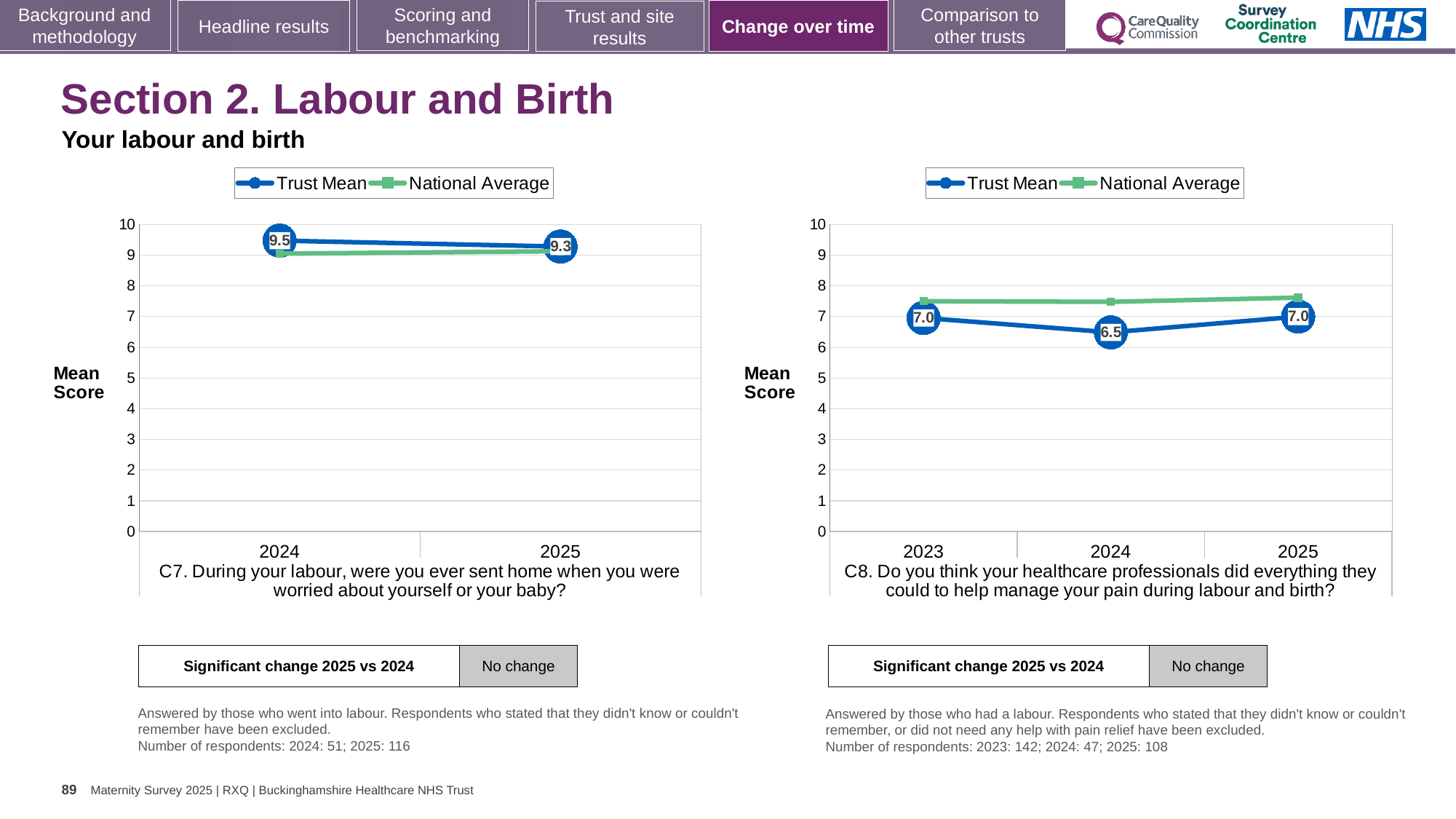
How many years are plotted on the x axis of the right chart (C8)? 3 In the right chart (C8), what is the difference between the Trust Mean for 2025 and 2024? 0.5 In the right chart (C8), which year has the lowest Trust Mean? 2024 In the left chart (C7), what is the Trust Mean for 2025? 9.3 In the right chart (C8), is the National Average for 2024 higher or lower than the Trust Mean for 2024? higher In the left chart (C7), what is the difference between the Trust Mean for 2024 and 2025? 0.2 In the right chart (C8), what is the Trust Mean for 2025? 7.0 How many series does the legend of the left chart (C7) list? 2 In the left chart (C7), is the National Average for 2024 greater or less than 8? greater In the left chart (C7), what is the Trust Mean for 2024? 9.5 In the right chart (C8), what is the Trust Mean for 2024? 6.5 In the left chart (C7), does the Trust Mean rise or fall from 2024 to 2025? fall